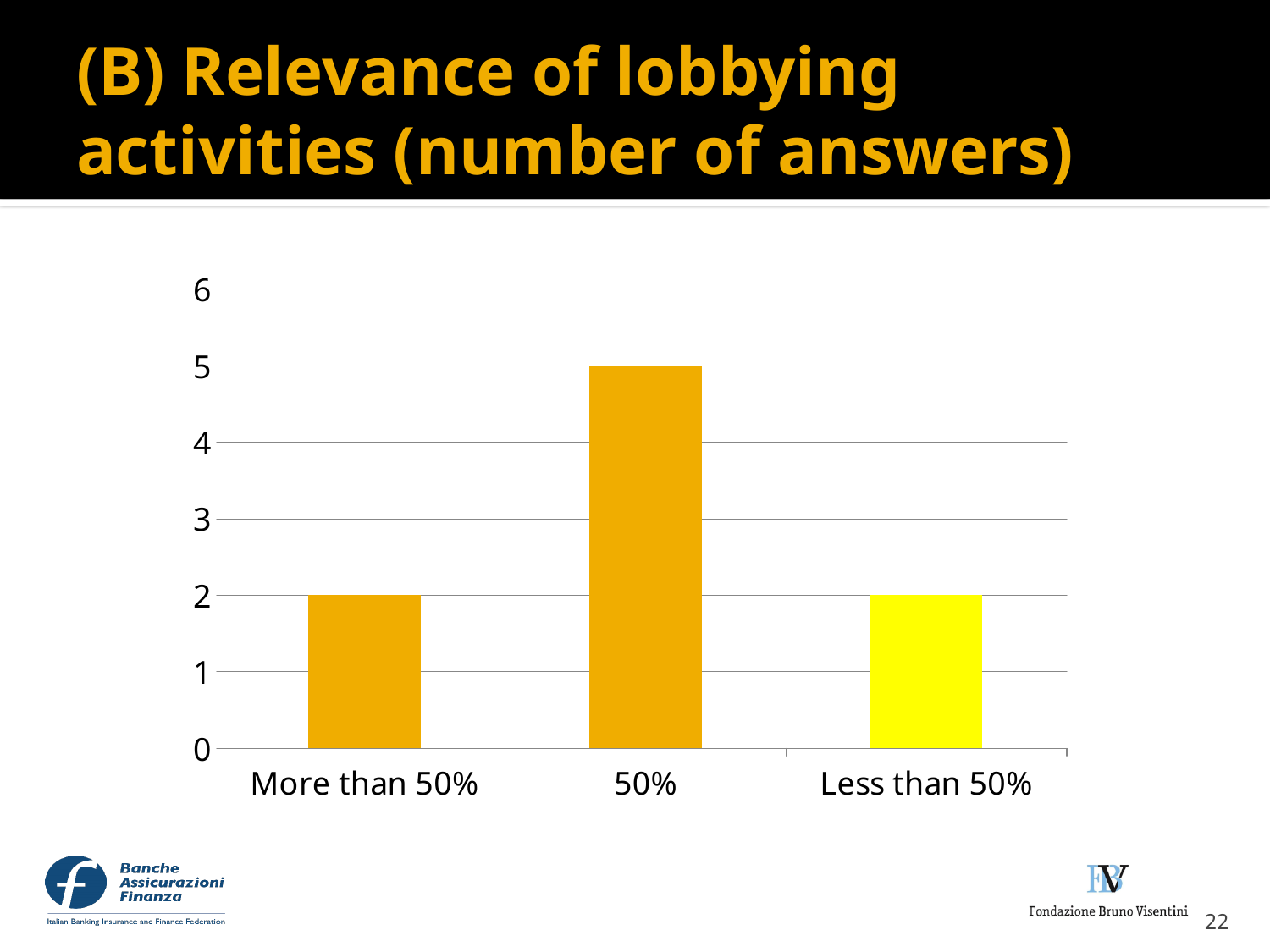
Which category has the highest number of answers? 50% What is the number of answers for "50%"? 5 What is the difference between the number of answers for "50%" and for "More than 50%"? 3 What is the number of answers for "Less than 50%"? 2 Which has more answers, "50%" or "Less than 50%"? 50% What kind of chart is shown on the slide? bar chart What is the highest value shown on the vertical axis? 6 Which category's bar is coloured differently (bright yellow) from the others? Less than 50% How many categories are shown on the x axis? 3 Is the value for "50%" greater or less than 4? greater Is the value for "More than 50%" greater or less than 3? less What is the number of answers for "More than 50%"? 2